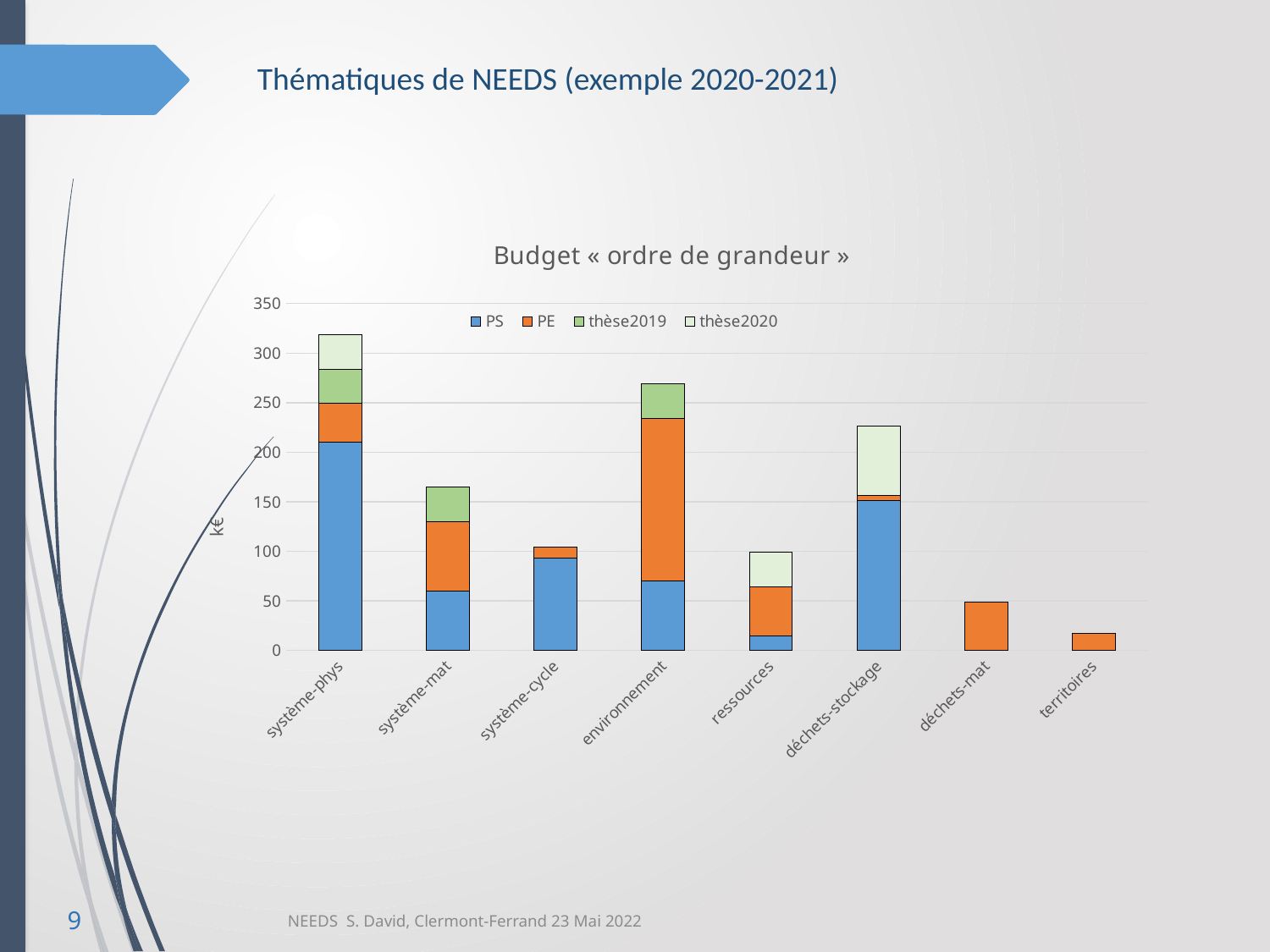
Is the total value for système-phys greater or less than 300? greater Which has the larger total bar, environnement or système-mat? environnement How many series does the legend list? 4 Which category has the highest total stacked bar? système-phys Is the total value for environnement greater or less than 250? greater Which category has the lowest total stacked bar? territoires How many categories are shown on the x axis? 8 What is the title of the chart? Budget « ordre de grandeur » What unit is shown on the y axis label? k€ What type of chart is shown on the slide? stacked bar chart Is the total value for territoires greater or less than 50? less